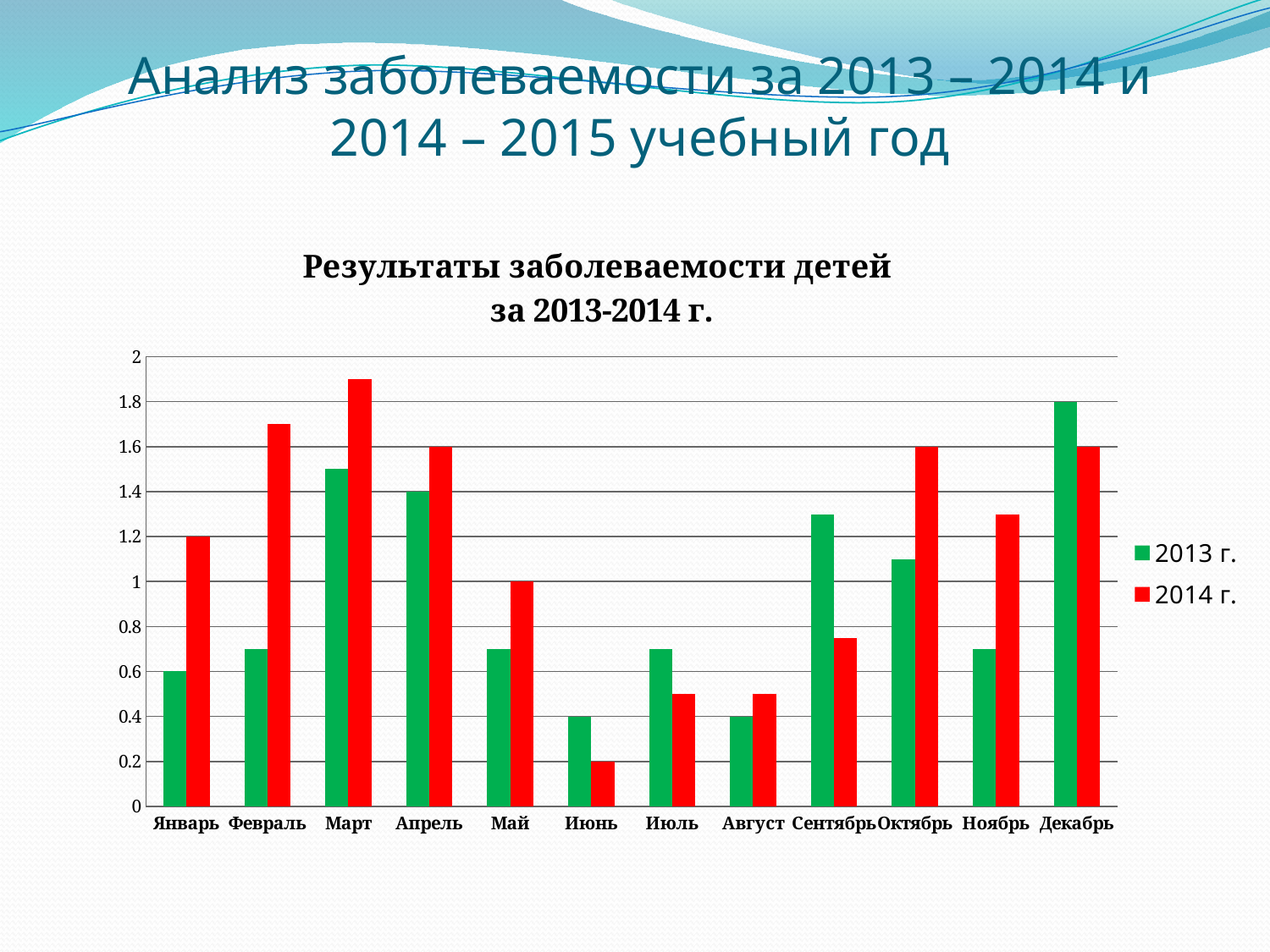
What colour are the bars for the 2014 г. series? red What is the value for Январь in the 2014 г. series? 1.2 In Декабрь, which series has the larger value, 2013 г. or 2014 г.? 2013 г. Is the value for Март in the 2014 г. series greater or less than 1.8? greater How many months are shown on the x axis? 12 What kind of chart is shown on the slide? bar chart What is the difference between the 2013 г. and 2014 г. values for Июнь? 0.2 Which month has the highest value for the 2013 г. series? Декабрь Which month has the lowest value for the 2014 г. series? Июнь How many series does the legend list? 2 What is the value for Июнь in the 2013 г. series? 0.4 Which month has the highest value for the 2014 г. series? Март